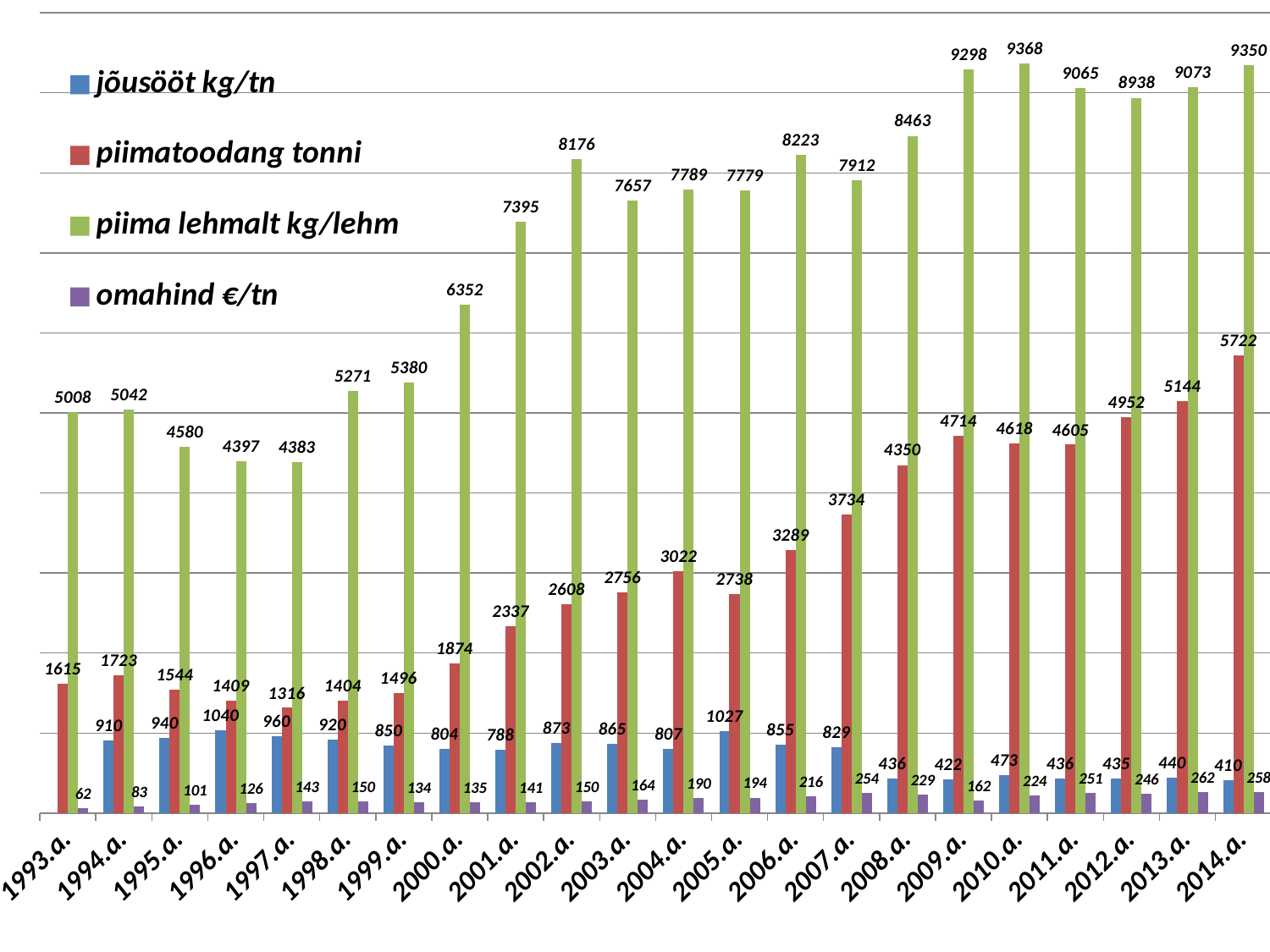
In which year is omahind €/tn the highest? 2013.a. What is the difference between piimatoodang tonni in 2014.a. and in 2013.a.? 578 What is the value of omahind €/tn for 1993.a.? 62 How many series does the legend list? 4 What is the value of piima lehmalt kg/lehm for 2010.a.? 9368 What is the value of piimatoodang tonni for 2014.a.? 5722 Which is larger: piima lehmalt kg/lehm in 2002.a. or in 2003.a.? 2002.a. In which year is piima lehmalt kg/lehm the highest? 2010.a. How many years are shown on the x axis? 22 What is the value of jõusööt kg/tn for 2005.a.? 1027 What kind of chart is this? Bar chart In which year is piimatoodang tonni the lowest? 1997.a.